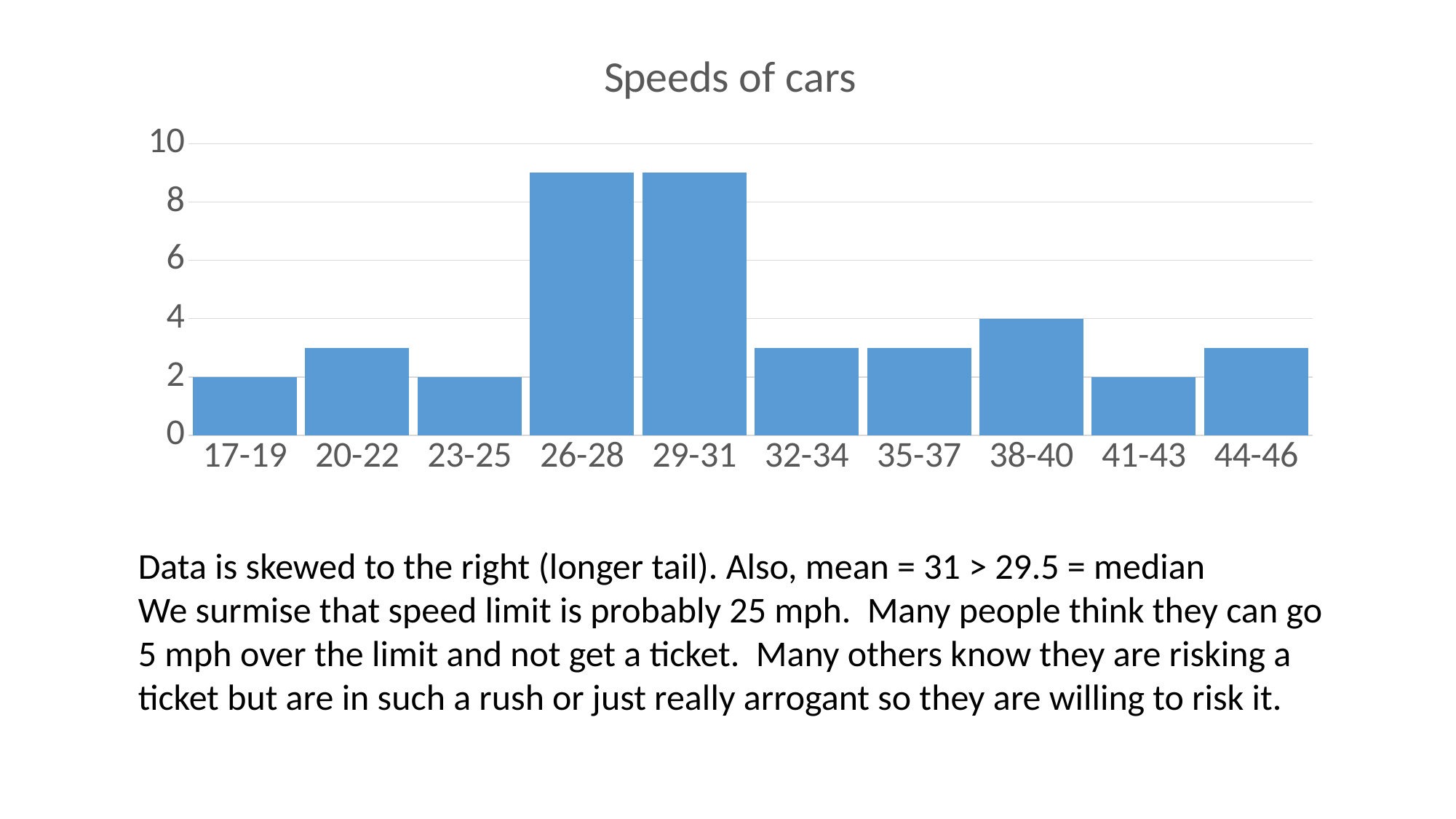
Which is larger, the value for 38-40 or the value for 41-43? 38-40 What is the value for the 23-25 category? 2 What is the value for the 38-40 category? 4 What is the title of the chart? Speeds of cars What is the difference between the value for 38-40 and the value for 17-19? 2 Is the value for 26-28 greater or less than 8? greater Which is larger, the value for 29-31 or the value for 32-34? 29-31 Is the value for 20-22 greater or less than 4? less What is the value for the 17-19 category? 2 How many speed categories are shown on the x axis? 10 What kind of chart is shown on the slide? bar chart What is the value for the 41-43 category? 2